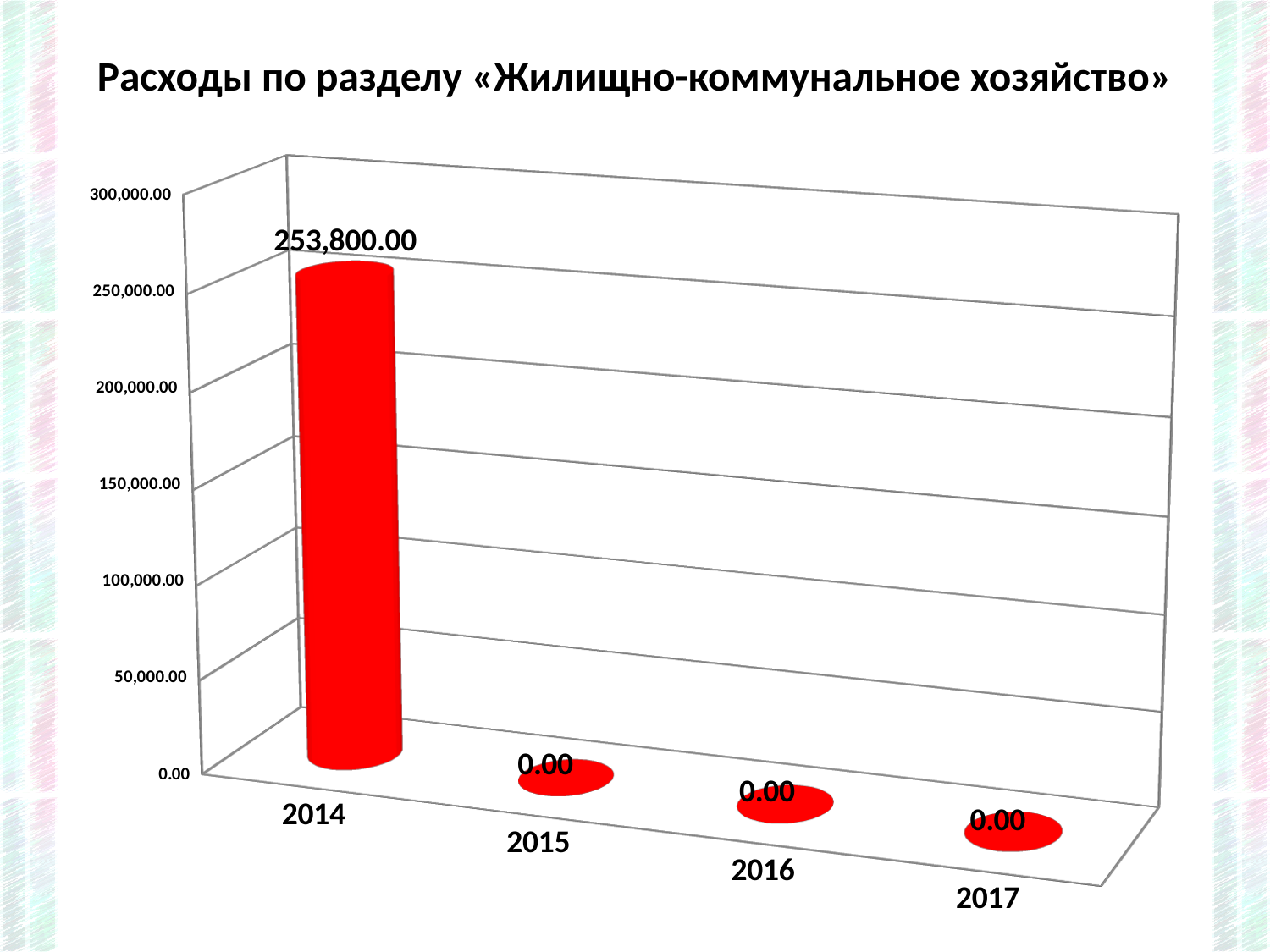
What kind of chart is shown on the slide? bar chart What is the value for 2015? 0.00 Do the values rise or fall from 2014 to 2015? fall Which year has the highest value? 2014 What is the title of the chart? Расходы по разделу «Жилищно-коммунальное хозяйство» Which is larger, the value for 2014 or the value for 2015? 2014 What colour are the bars in the chart? red What is the value for 2014? 253,800.00 How many years are shown on the x axis? 4 What is the value for 2017? 0.00 Is the value for 2014 greater or less than 250,000.00? greater What is the difference between the values for 2014 and 2016? 253,800.00